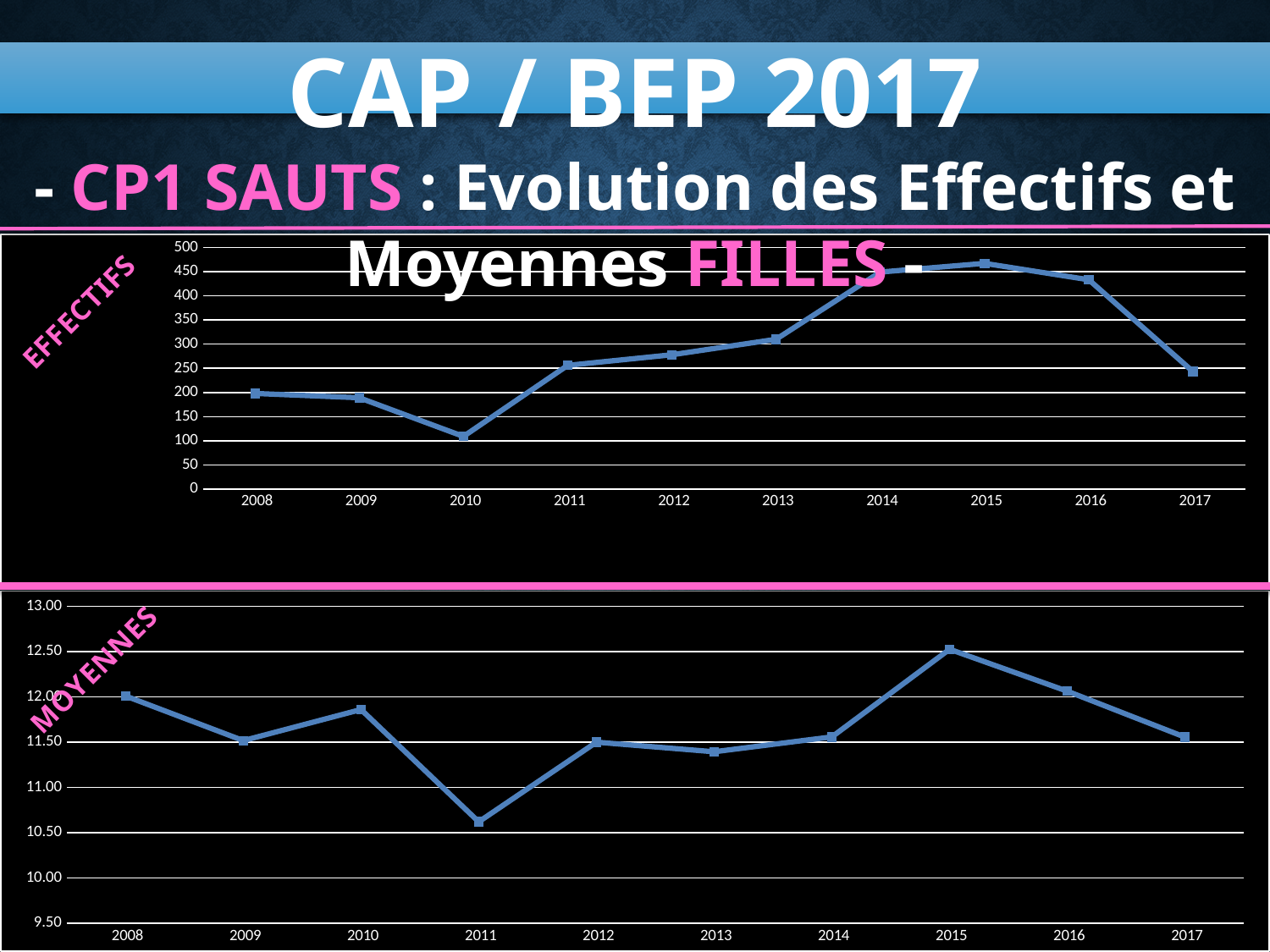
How many years are plotted on the top chart (EFFECTIFS)? 10 In the top chart (EFFECTIFS), do the values rise or fall from 2015 to 2017? fall In the bottom chart (MOYENNES), which year has the lowest value? 2011 In the top chart (EFFECTIFS), is the value for 2010 greater or less than 150? less In the top chart (EFFECTIFS), which year has the lowest value? 2010 In the bottom chart (MOYENNES), is the value for 2011 greater or less than 11.00? less In the bottom chart (MOYENNES), which year has the highest value? 2015 In the top chart (EFFECTIFS), is the value for 2014 greater or less than 400? greater What kind of chart is the top chart (EFFECTIFS)? line chart In the top chart (EFFECTIFS), which year has the highest value? 2015 In the bottom chart (MOYENNES), which is larger, the value for 2010 or the value for 2013? 2010 In the top chart (EFFECTIFS), which is larger, the value for 2012 or the value for 2017? 2012